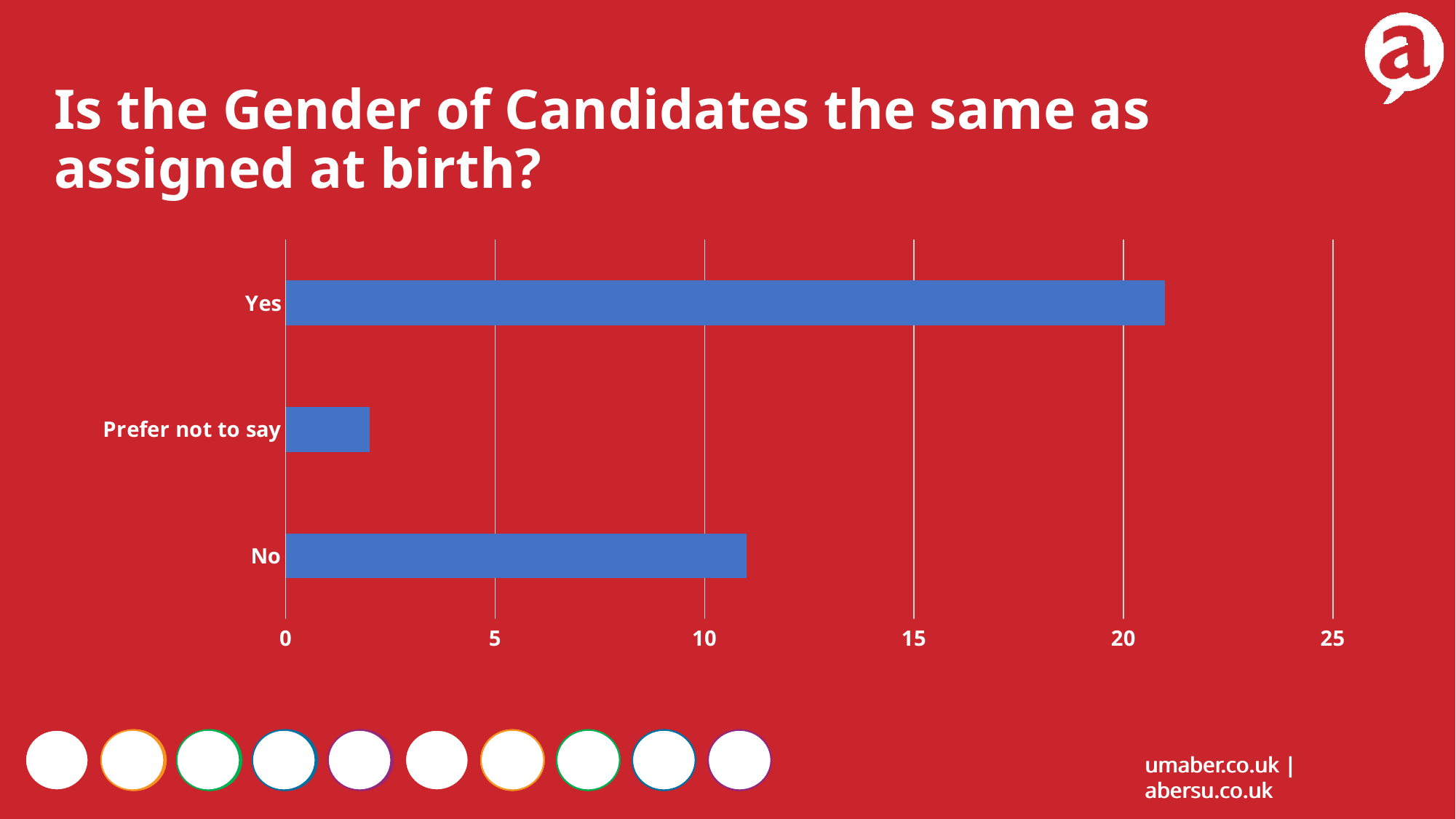
What kind of chart is shown on the slide? bar chart Which category has the highest value? Yes Is the value for Yes greater or less than 20? greater Which is larger, the value for No or the value for Prefer not to say? No Which category has the lowest value? Prefer not to say What is the title of the chart on the slide? Is the Gender of Candidates the same as assigned at birth? Is the value for Prefer not to say greater or less than 5? less How many categories are shown in the chart? 3 Is the value for No greater or less than 15? less What is the highest value shown on the horizontal axis? 25 Which is larger, the value for Yes or the value for No? Yes